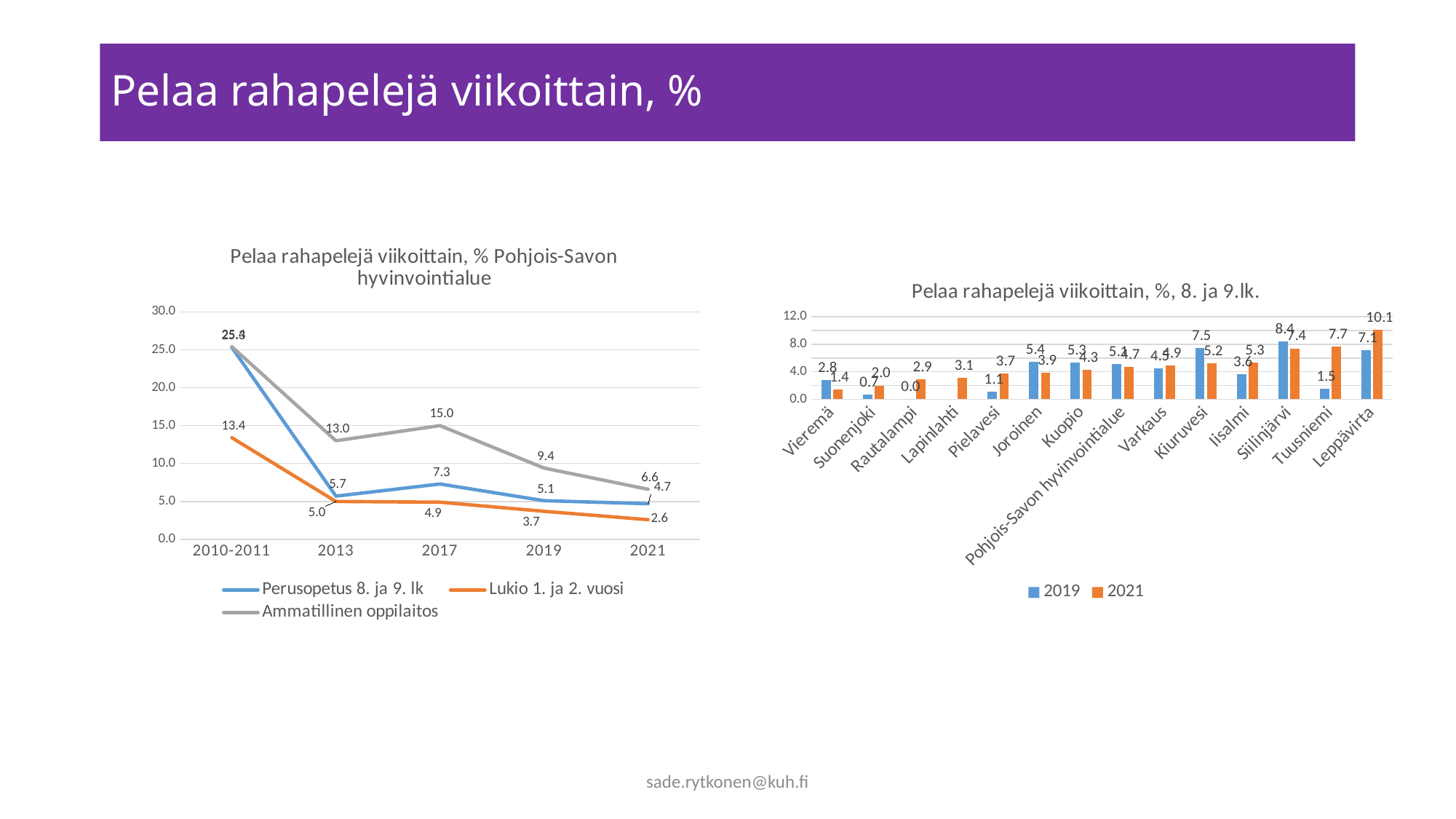
In the left chart, does the Lukio 1. ja 2. vuosi line rise or fall from 2010-2011 to 2021? fall In the left chart, what is the difference between Ammatillinen oppilaitos and Perusopetus 8. ja 9. lk in 2019? 4.3 In the right chart, what is the 2021 value for Tuusniemi? 7.7 In the left chart, what is the value for Lukio 1. ja 2. vuosi in 2021? 2.6 In the left chart, what is the value for Ammatillinen oppilaitos in 2017? 15.0 What kind of chart is the left chart titled 'Pelaa rahapelejä viikoittain, % Pohjois-Savon hyvinvointialue'? line chart In the right chart, which category has the highest 2019 value? Siilinjärvi In the left chart, how many series does the legend list? 3 What kind of chart is the right chart titled 'Pelaa rahapelejä viikoittain, %, 8. ja 9.lk.'? bar chart In the right chart, which is larger for Kiuruvesi: the 2019 value or the 2021 value? 2019 In the right chart, how many categories are shown on the x axis? 14 In the right chart, which municipality has the highest 2021 value? Leppävirta